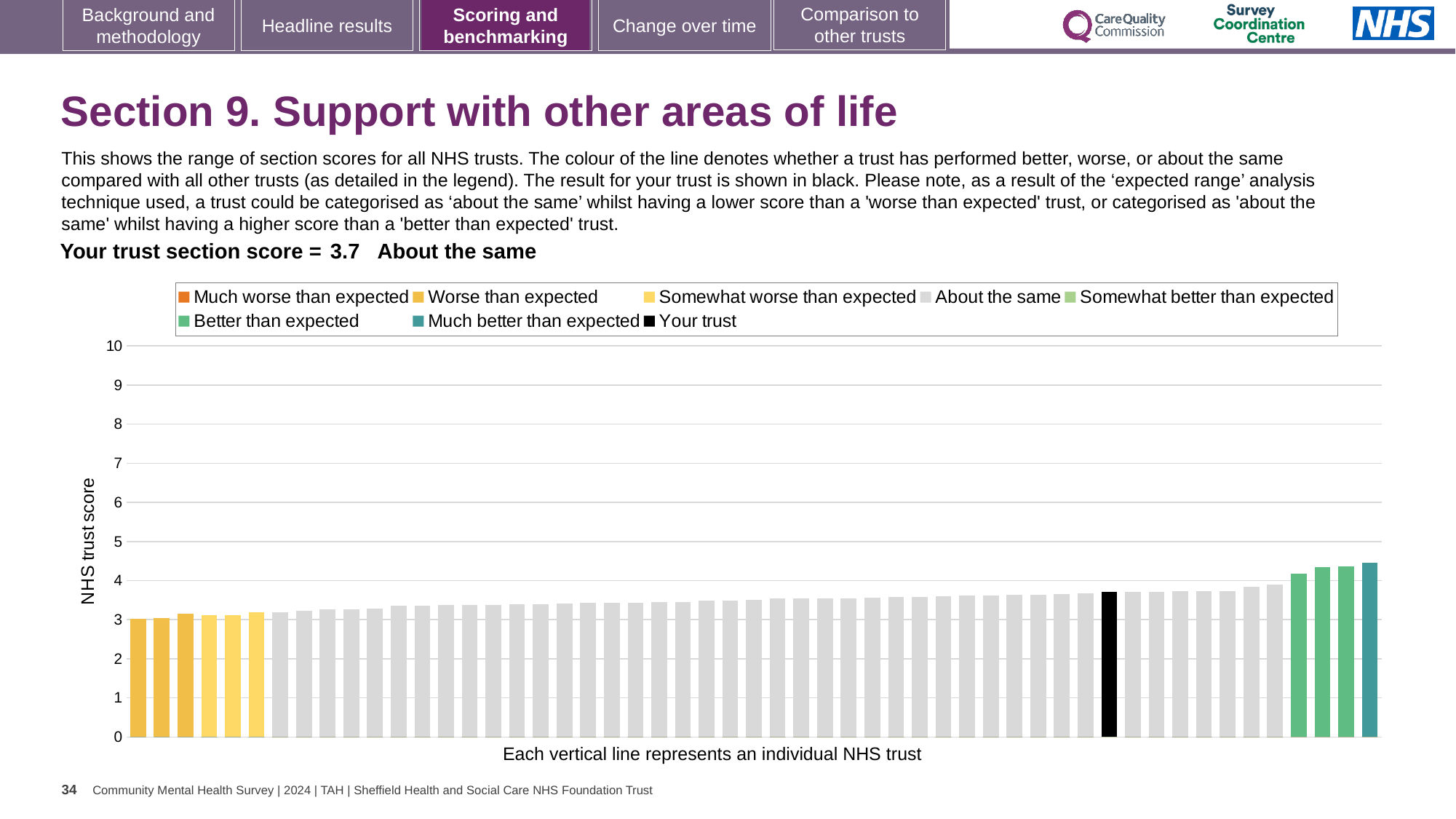
What is the section score for your trust shown on the slide? 3.7 How many bars are coloured as 'Worse than expected' (yellow) on the chart? 3 Is the value for the highest-scoring trust greater or less than 5? less How many entries does the chart legend list? 8 Do the trust scores rise or fall moving from left to right along the x axis? rise What kind of chart is shown on the slide? bar chart What colour is used for the bar representing your trust? black What is the label on the vertical axis of the chart? NHS trust score Is the value for the lowest-scoring trust greater or less than 4? less Is the value for the highest-scoring trust greater or less than 4? greater Which performance category is your trust placed in for this section? About the same